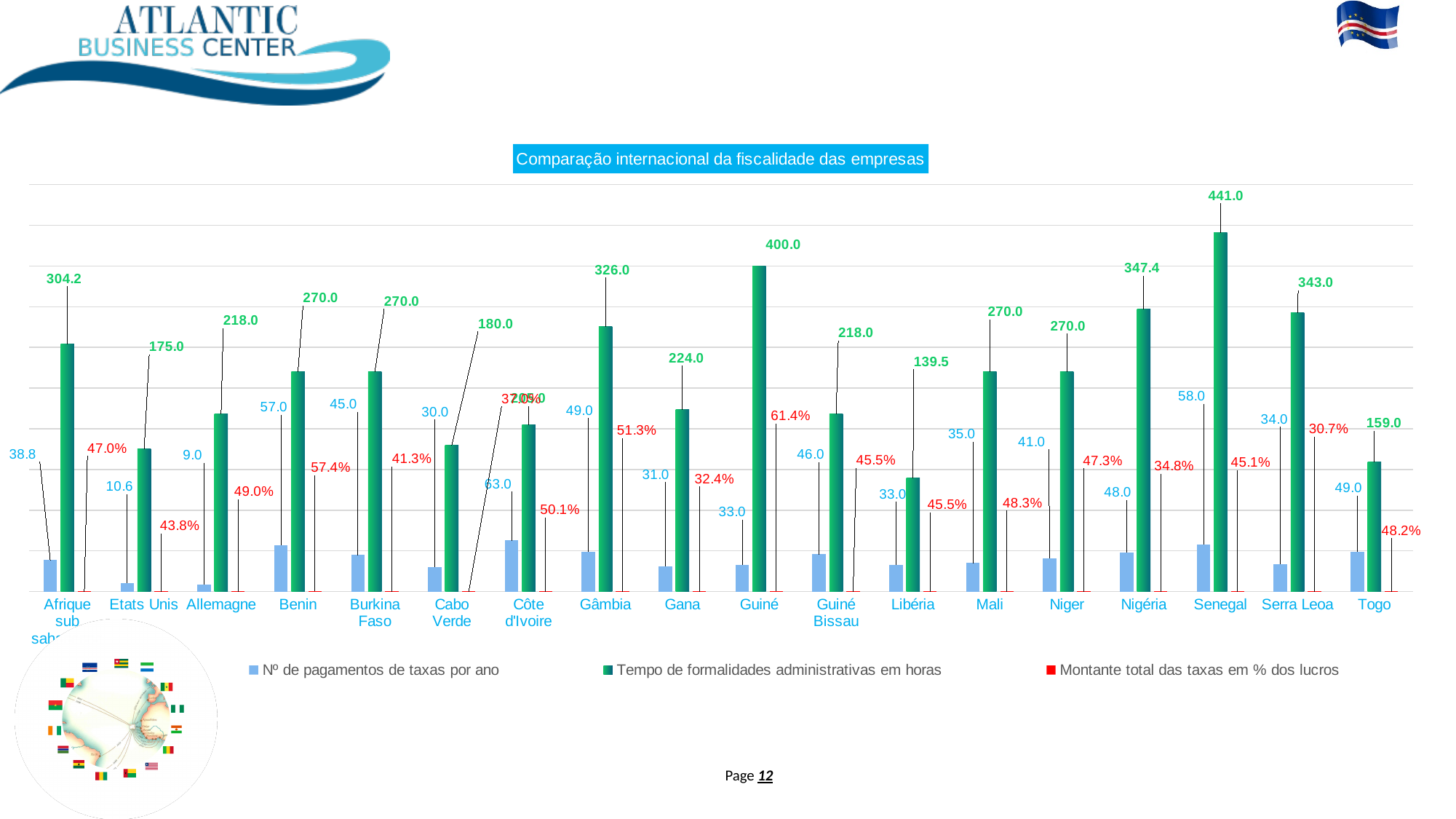
What kind of chart is shown on the slide? bar chart What is the difference between the 'Tempo de formalidades administrativas em horas' values for Senegal and Guiné? 41.0 How many series does the legend list? 3 What is the value of 'Nº de pagamentos de taxas por ano' for Etats Unis? 10.6 Which category has the lowest value for 'Tempo de formalidades administrativas em horas'? Libéria Which country has the highest value for 'Tempo de formalidades administrativas em horas'? Senegal What is the title of the chart? Comparação internacional da fiscalidade das empresas What is the value of 'Montante total das taxas em % dos lucros' for Guiné? 61.4% Which category has the highest value for 'Montante total das taxas em % dos lucros'? Guiné What is the value of 'Tempo de formalidades administrativas em horas' for Senegal? 441.0 What is the value of 'Nº de pagamentos de taxas por ano' for Allemagne? 9.0 Which is larger, the 'Tempo de formalidades administrativas em horas' value for Gâmbia or for Gana? Gâmbia